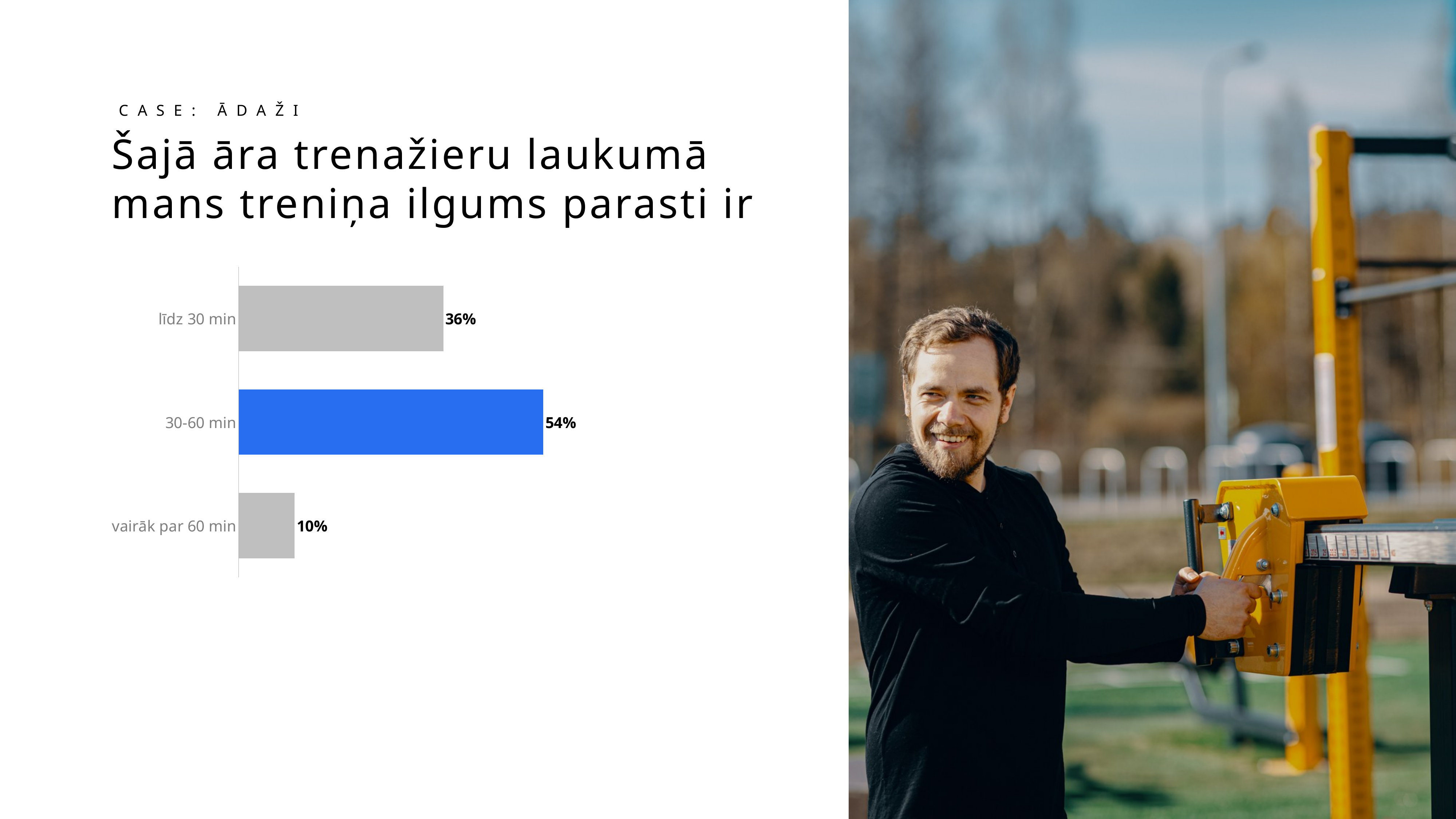
How many categories does the chart show? 3 Which category has the highest value? 30-60 min What is the difference between the values for "30-60 min" and "līdz 30 min"? 18% What is the value for "līdz 30 min"? 36% Which category has the lowest value? vairāk par 60 min What is the difference between the values for "līdz 30 min" and "vairāk par 60 min"? 26% What is the value for "vairāk par 60 min"? 10% What kind of chart is shown on the slide? bar chart Which is larger, the value for "līdz 30 min" or the value for "vairāk par 60 min"? līdz 30 min What is the value for "30-60 min"? 54% What is the total of the three values shown in the chart? 100% Which category's bar is coloured blue? 30-60 min